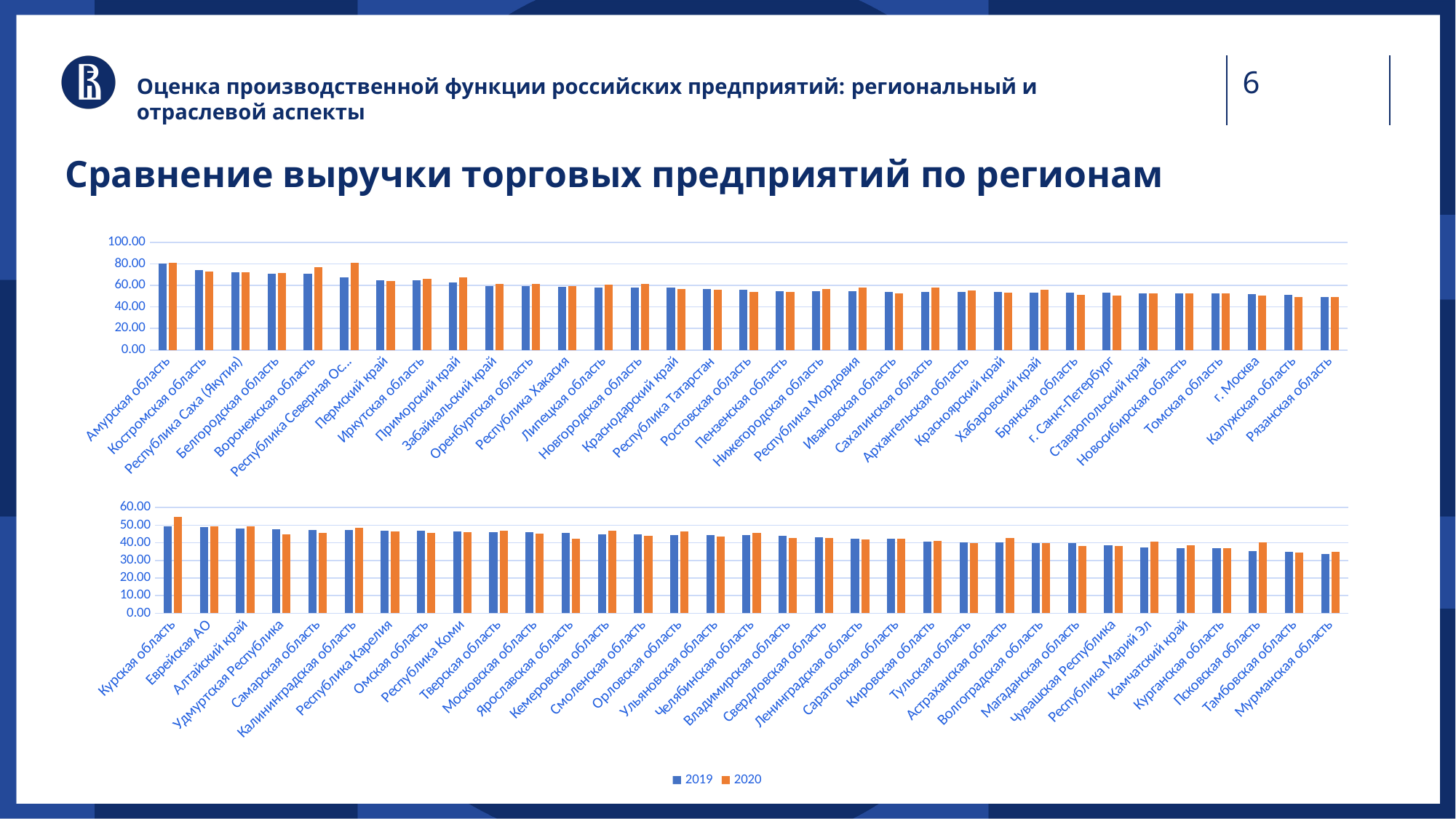
On the bottom chart, is the 2019 value for Мурманская область greater or less than 40? less How many series does the legend list for the charts? 2 On the bottom chart, is the 2020 value for Курская область greater or less than 50? greater How many regions are shown on the bottom chart? 33 On the top chart, is the 2019 value for Амурская область greater or less than 60? greater On the bottom chart, which is larger for Ярославская область: the 2019 value or the 2020 value? 2019 What kind of chart is the top chart on the slide? bar chart On the top chart, which region has the highest 2019 value? Амурская область On the bottom chart, which region has the highest 2020 value? Курская область How many regions are shown on the top chart? 33 Which two series are shown in the legend? 2019 and 2020